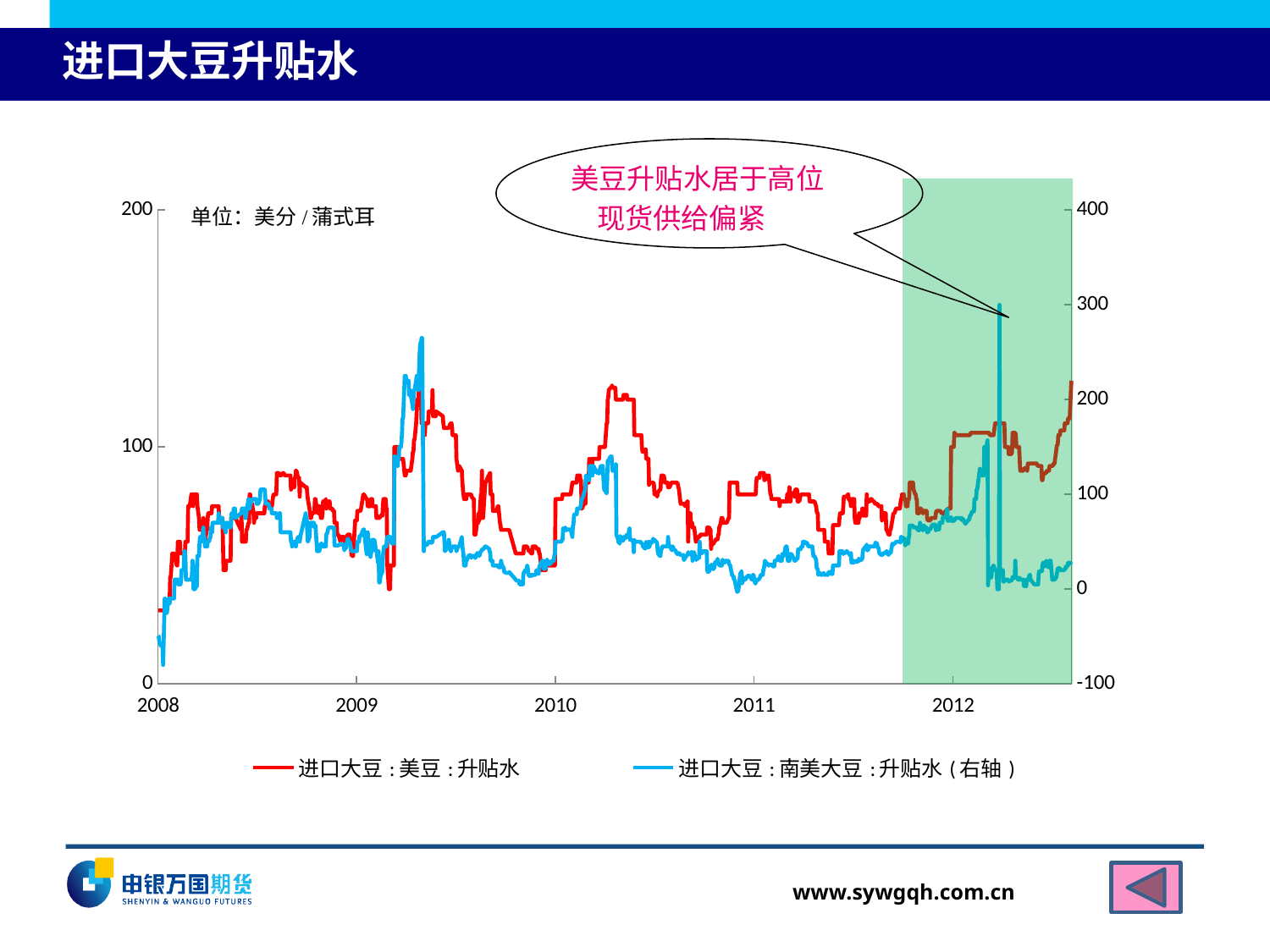
How many series does the legend list? 2 Is the value of the 进口大豆:南美大豆:升贴水(右轴) series at the end of 2012 greater or less than 100 on the right axis? less Is the peak value of the 进口大豆:美豆:升贴水 series in 2009 greater or less than 100? greater How many year labels are shown on the x axis? 5 What is the highest value shown on the right axis? 400 What is the title of the slide's chart? 进口大豆升贴水 Does the 进口大豆:美豆:升贴水 series rise or fall across the shaded region at the right of the chart? rise Is the spike of the 进口大豆:南美大豆:升贴水(右轴) series in 2012 greater or less than 200 on the right axis? greater What unit is stated on the chart? 美分/蒲式耳 Which series is plotted against the right axis? 进口大豆:南美大豆:升贴水(右轴) What kind of chart is shown on the slide? line chart